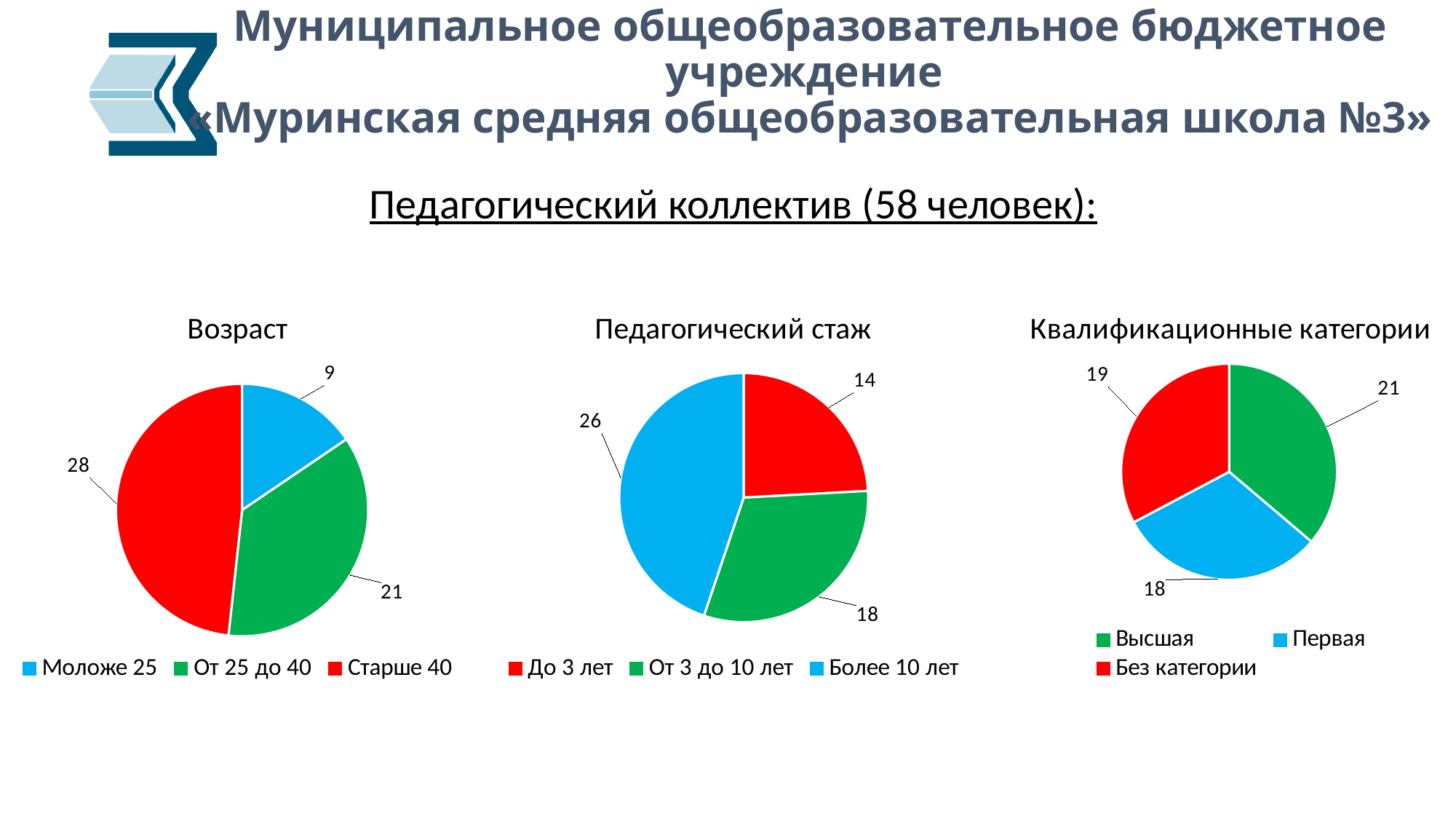
In the 'Квалификационные категории' chart, which colour represents 'Без категории'? Red In the 'Педагогический стаж' chart, which is larger: 'До 3 лет' or 'От 3 до 10 лет'? От 3 до 10 лет In the 'Возраст' chart, which category has the smallest value? Моложе 25 In the 'Квалификационные категории' chart, what is the difference between 'Высшая' and 'Первая'? 3 In the 'Педагогический стаж' chart, which category has the largest value? Более 10 лет In the 'Квалификационные категории' chart, which category has the largest value? Высшая In the 'Квалификационные категории' chart, what is the value for 'Первая'? 18 In the 'Педагогический стаж' chart, what is the value for 'Более 10 лет'? 26 What kind of chart is the 'Возраст' chart? Pie chart In the 'Возраст' chart, what is the value for 'Старше 40'? 28 How many categories does the 'Педагогический стаж' chart show? 3 In the 'Возраст' chart, what is the difference between 'Старше 40' and 'Моложе 25'? 19